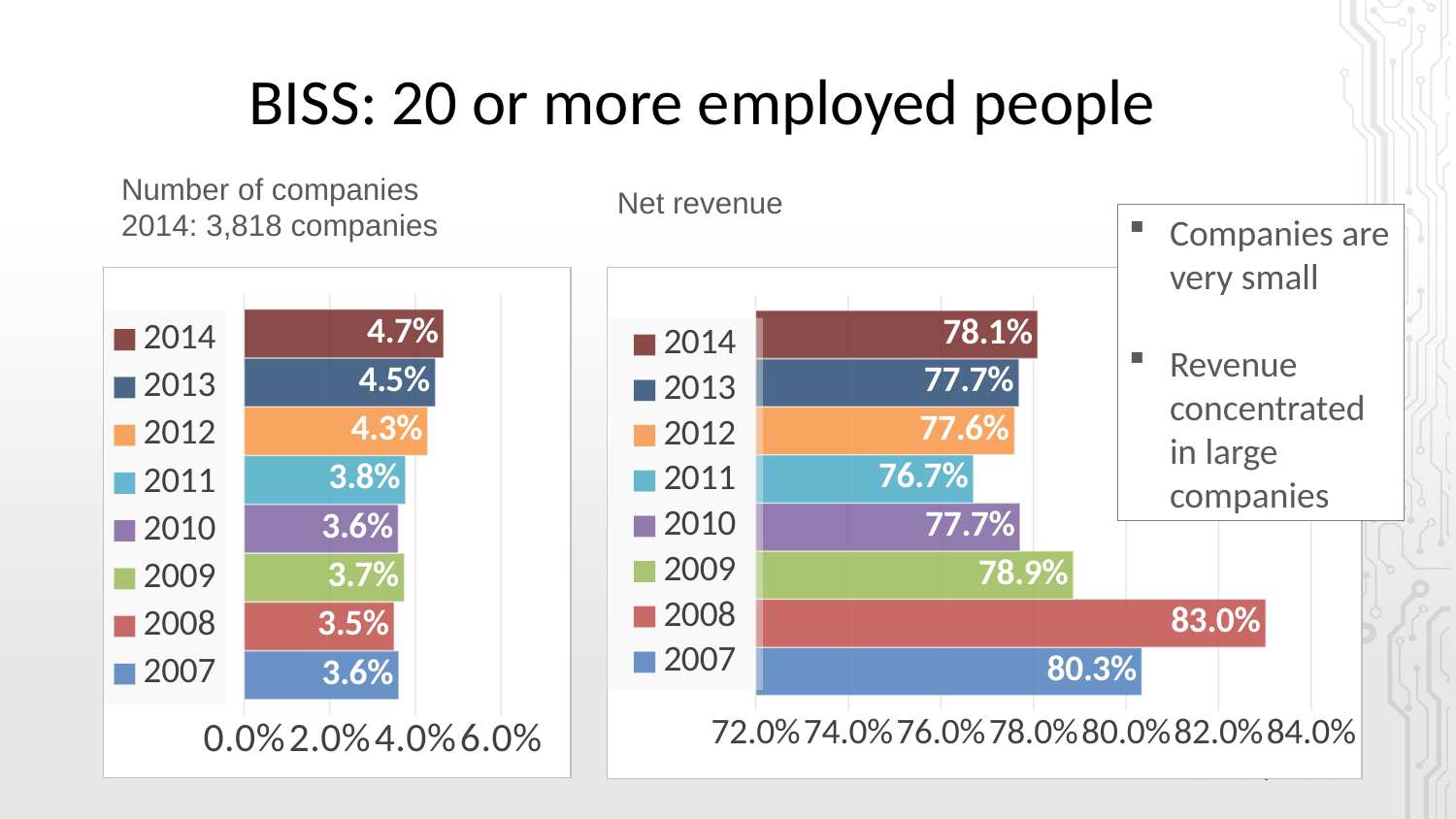
In the Number of companies chart, which year has the lowest value? 2008 In the Number of companies chart, what is the difference between the values for 2014 and 2007? 1.1% In the Net revenue chart, which is larger, the value for 2007 or the value for 2009? 2007 What kind of chart is the Net revenue chart? Bar chart In the Number of companies chart, which year has the highest value? 2014 In the Net revenue chart, what is the value for 2011? 76.7% How many years are plotted in the Number of companies chart? 8 In the Net revenue chart, what is the value for 2008? 83.0% In the Net revenue chart, which year has the highest value? 2008 In the Net revenue chart, which year has the lowest value? 2011 In the Number of companies chart, what is the value for 2014? 4.7% In the Net revenue chart, what is the difference between the values for 2008 and 2014? 4.9%